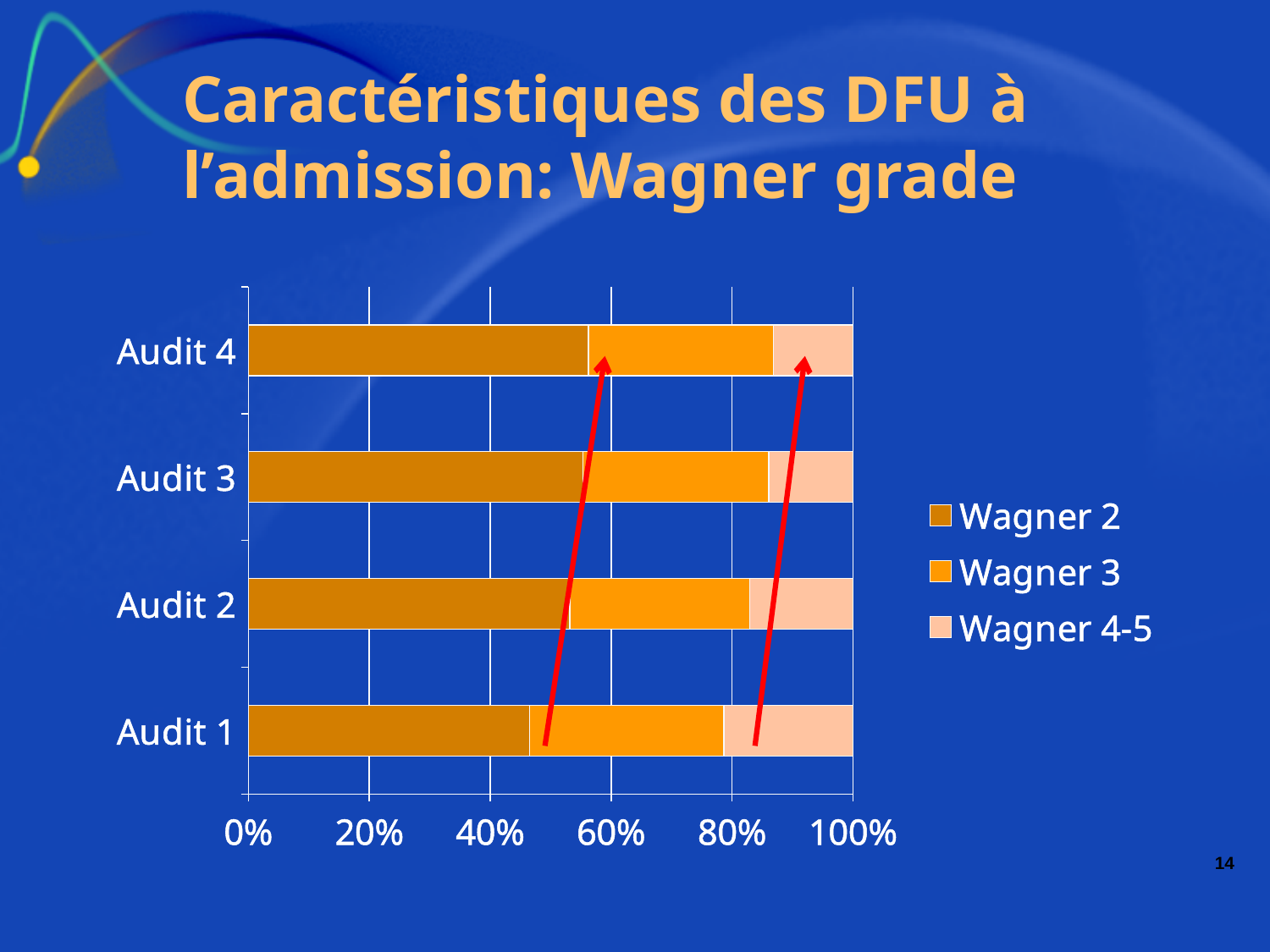
How many audits (categories) are shown on the chart? 4 Which audit has the smallest Wagner 2 share? Audit 1 What kind of chart is shown on the slide? Stacked bar chart Is the Wagner 2 share for Audit 1 greater or less than 60%? less Does the Wagner 2 share rise or fall from Audit 1 to Audit 4? rise What is the title of the slide containing the chart? Caractéristiques des DFU à l'admission: Wagner grade How many series does the legend list? 3 Is the Wagner 2 share larger for Audit 1 or for Audit 4? Audit 4 Is the Wagner 2 share for Audit 4 greater or less than 40%? greater What are the three series listed in the legend? Wagner 2, Wagner 3, Wagner 4-5 Which audit has the largest Wagner 4-5 share? Audit 1 Is the Wagner 2 share for Audit 1 greater or less than 40%? greater